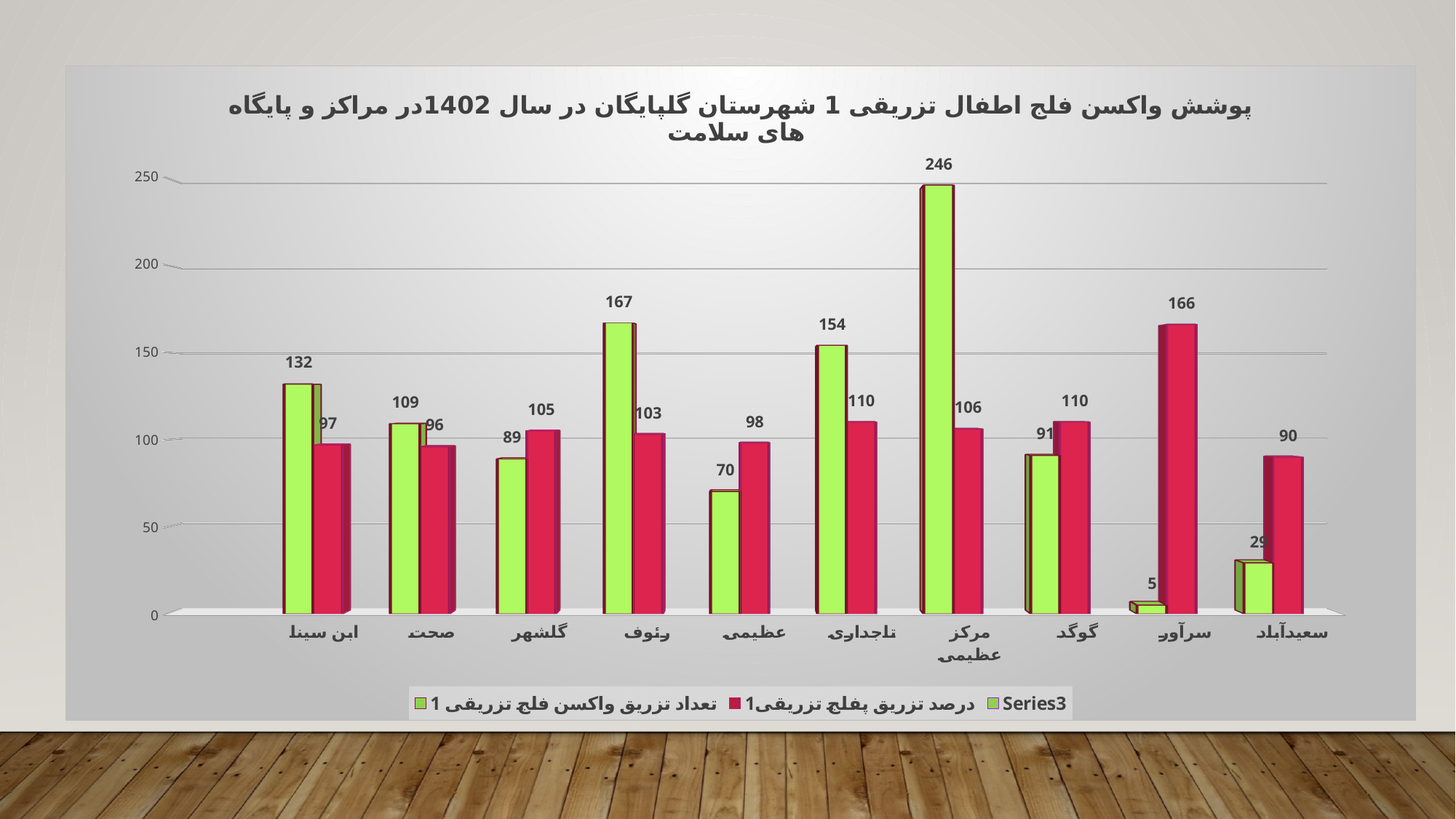
What is the value of the red series (درصد تزریق پفلج تزریقی1) for سرآور? 166 What is the value of the green series (تعداد تزریق واکسن فلج تزریقی 1) for ابن سینا? 132 How many series does the legend list? 3 Is the green series value for تاجداری greater or less than 150? greater How many categories are shown on the x axis? 10 What is the difference between the green and red values for رئوف? 64 For عظیمی, which is larger: the green series value or the red series value? the red series (98) Which category has the highest value in the green series (تعداد تزریق واکسن فلج تزریقی 1)? مرکز عظیمی Which category has the lowest value in the green series (تعداد تزریق واکسن فلج تزریقی 1)? سرآور Which category has the highest value in the red series (درصد تزریق پفلج تزریقی1)? سرآور What is the value of the green series for مرکز عظیمی? 246 What kind of chart is shown on the slide? bar chart